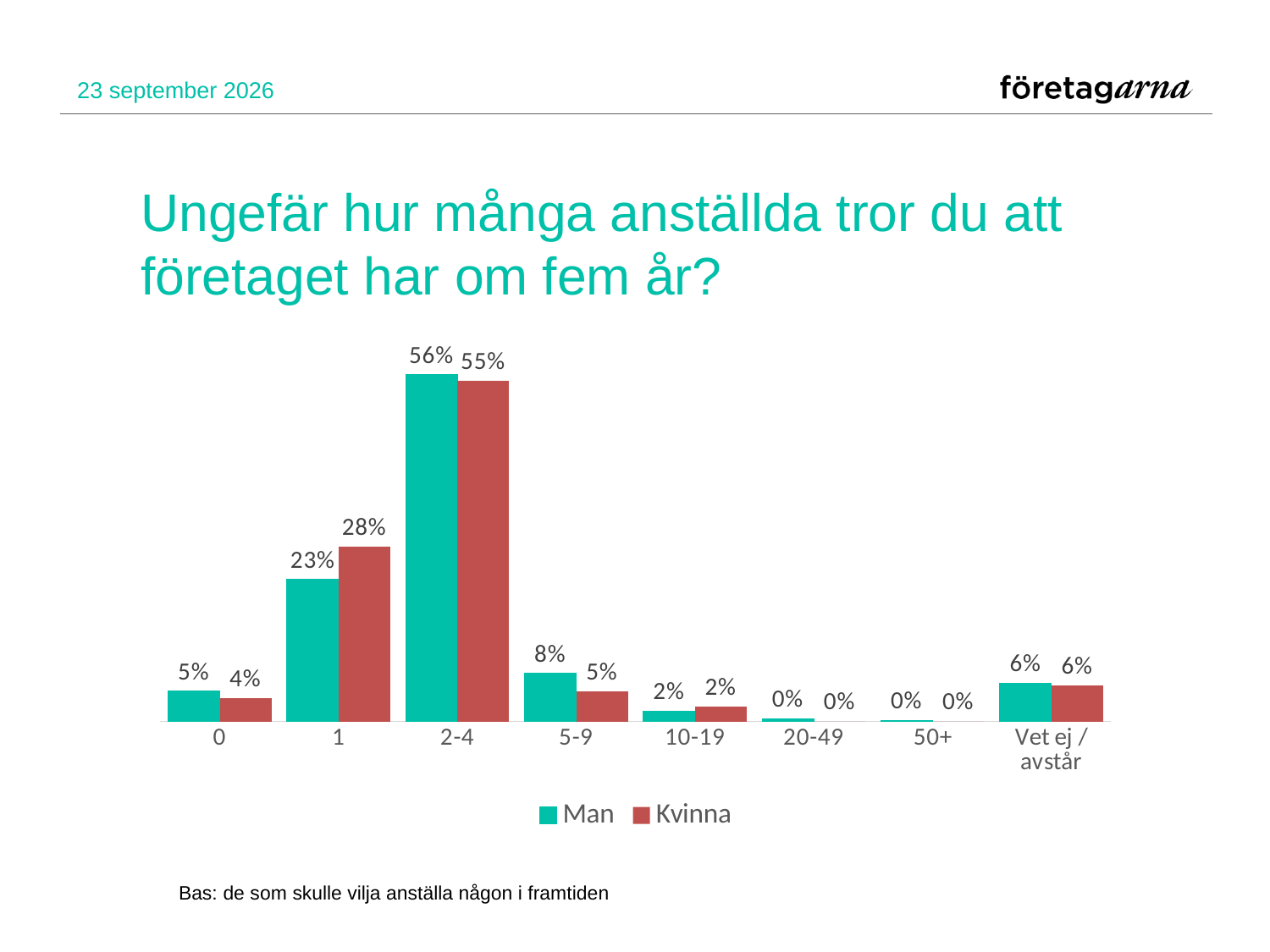
What kind of chart is shown on the slide? Bar chart What is the value for Man in the 2-4 category? 56% Which category has the highest value for Kvinna? 2-4 How many series does the legend list? 2 Which series is shown in red? Kvinna What is the value for Man in the Vet ej / avstår category? 6% What is the value for Kvinna in the 1 category? 28% What is the value for Kvinna in the 5-9 category? 5% What is the difference between Man and Kvinna in the 1 category? 5% What is the difference between Man and Kvinna in the 5-9 category? 3% How many categories are shown on the x axis? 8 Which is larger in the 0 category, Man or Kvinna? Man